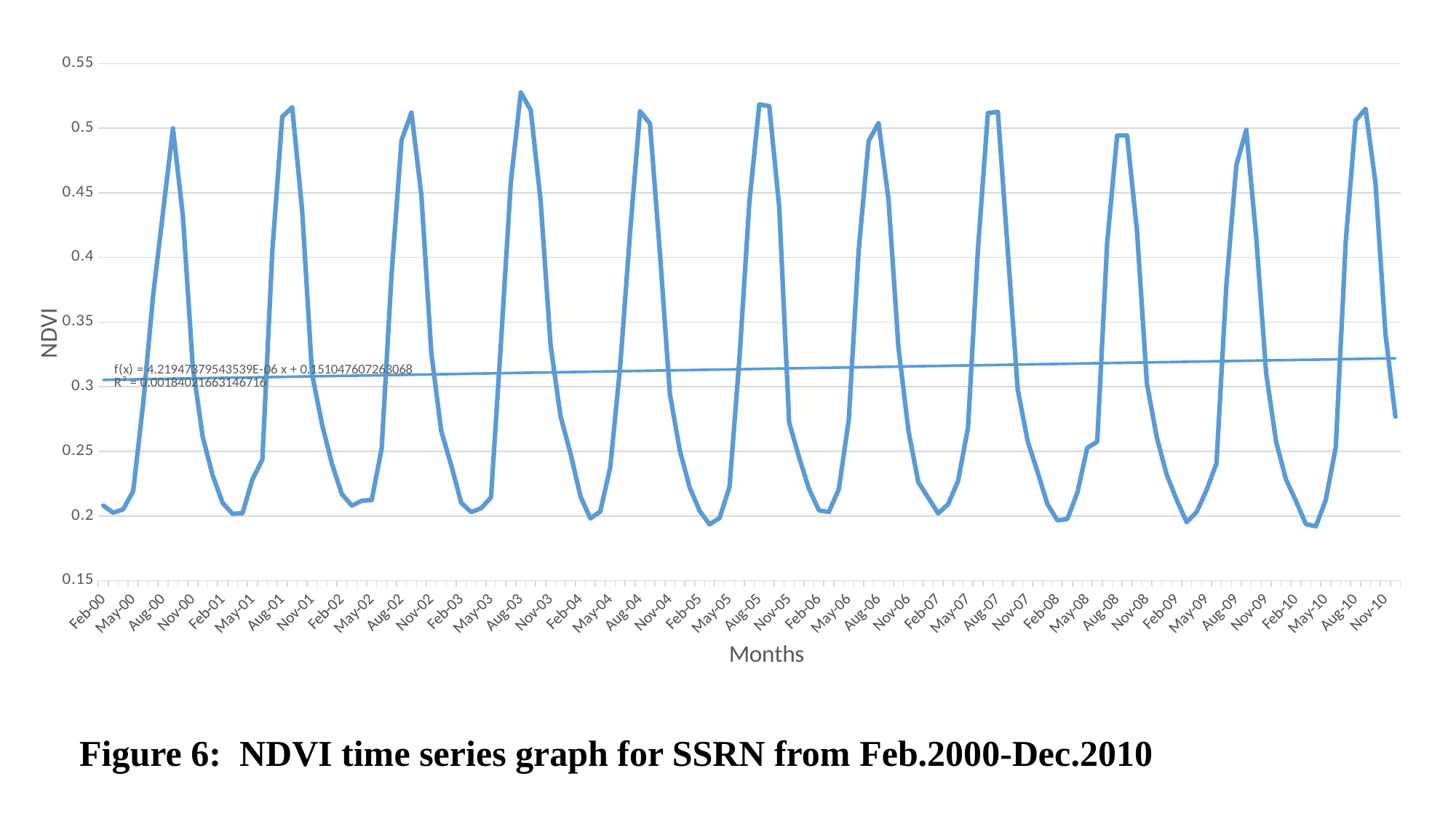
Is the NDVI value at May-03 greater or less than 0.25? less In which year does the NDVI series reach its highest peak? 2003 What is the title of the vertical axis? NDVI Is the NDVI value at Nov-10 greater or less than 0.3? greater What kind of chart is shown on the slide? line chart Is the NDVI value at Aug-03 greater or less than 0.5? greater What R² value is printed on the chart for the trendline? R² = 0.00184021663146716 Does the linear trendline rise or fall from left to right across the chart? rises